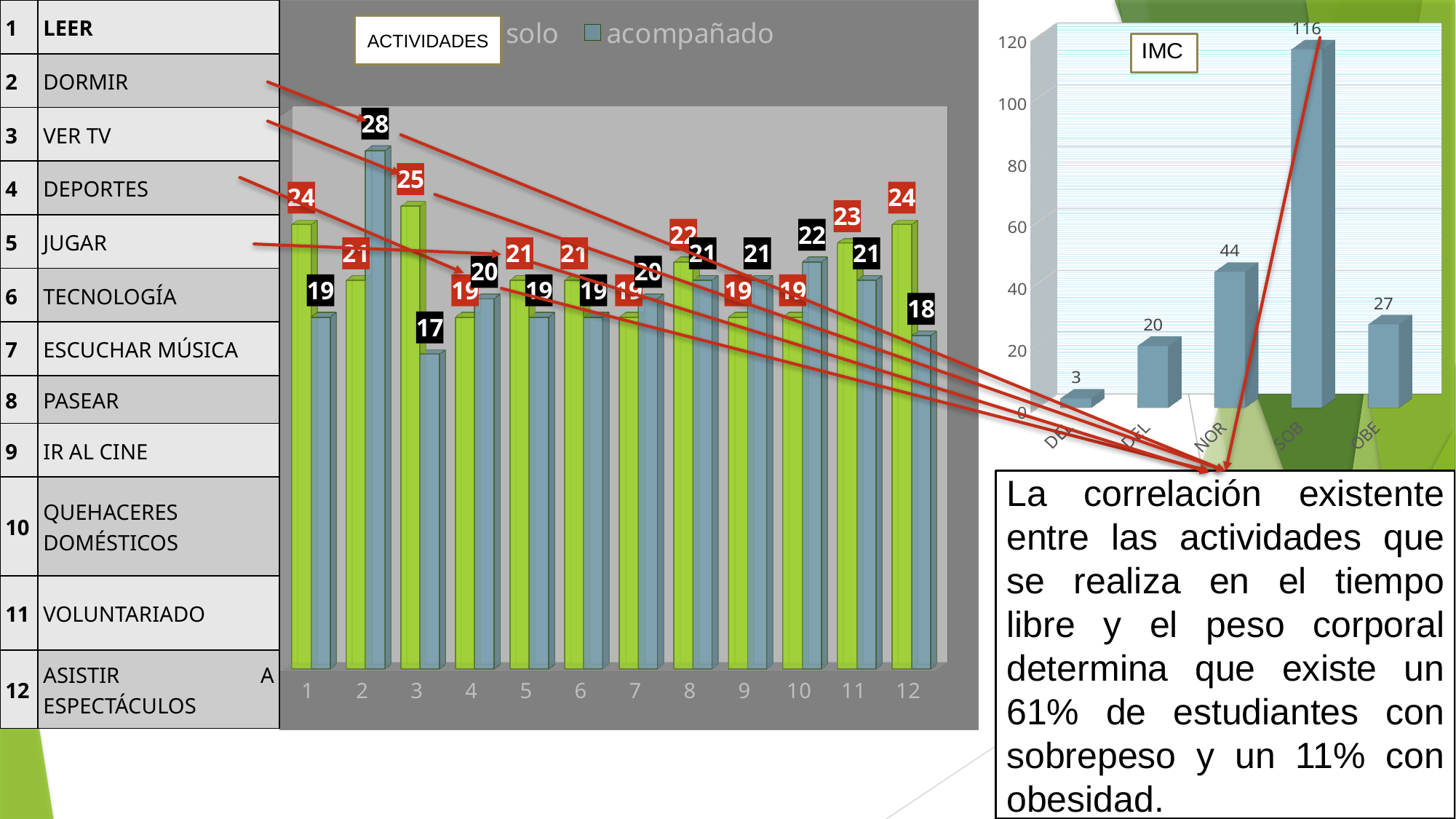
In the IMC chart, which category has the highest value? SOB In the ACTIVIDADES chart, how many series does the legend list? 2 In the IMC chart, how many categories are shown on the x axis? 5 In the IMC chart, what is the value for OBE? 27 What kind of chart is the ACTIVIDADES chart? bar chart In the IMC chart, what is the difference between the values for SOB and NOR? 72 In the ACTIVIDADES chart, which category has the highest acompañado value? 2 In the ACTIVIDADES chart, what is the solo value for category 3? 25 In the ACTIVIDADES chart, for category 12, which is larger: solo or acompañado? solo In the IMC chart, what is the value for NOR? 44 In the IMC chart, what is the value for SOB? 116 In the ACTIVIDADES chart, what is the acompañado value for category 2? 28